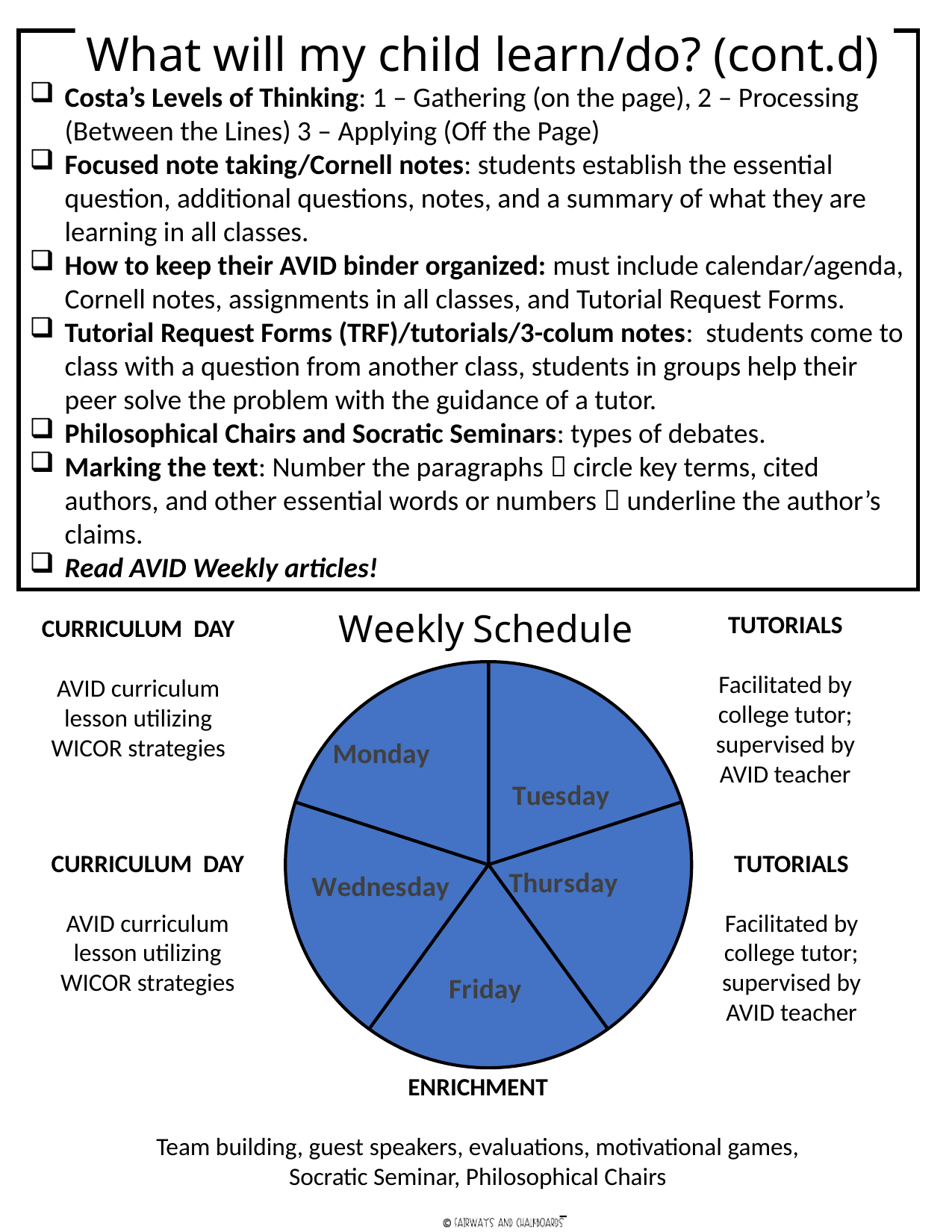
Which slice of the Weekly Schedule pie chart is at the bottom of the pie? Friday Which slice of the Weekly Schedule pie chart is at the top right of the pie? Tuesday Which slice of the Weekly Schedule pie chart lies between the Tuesday and Friday slices? Thursday What kind of chart is shown under the heading "Weekly Schedule"? pie chart Which days of the week are labelled on the slices of the Weekly Schedule pie chart? Monday, Tuesday, Wednesday, Thursday, Friday What is the title of the pie chart on the slide? Weekly Schedule Does the Weekly Schedule pie chart show a legend? No How many slices does the Weekly Schedule pie chart have? 5 Which slice of the Weekly Schedule pie chart is at the top left of the pie? Monday What colour are the slices of the Weekly Schedule pie chart? blue Which slice of the Weekly Schedule pie chart lies between the Monday and Friday slices? Wednesday